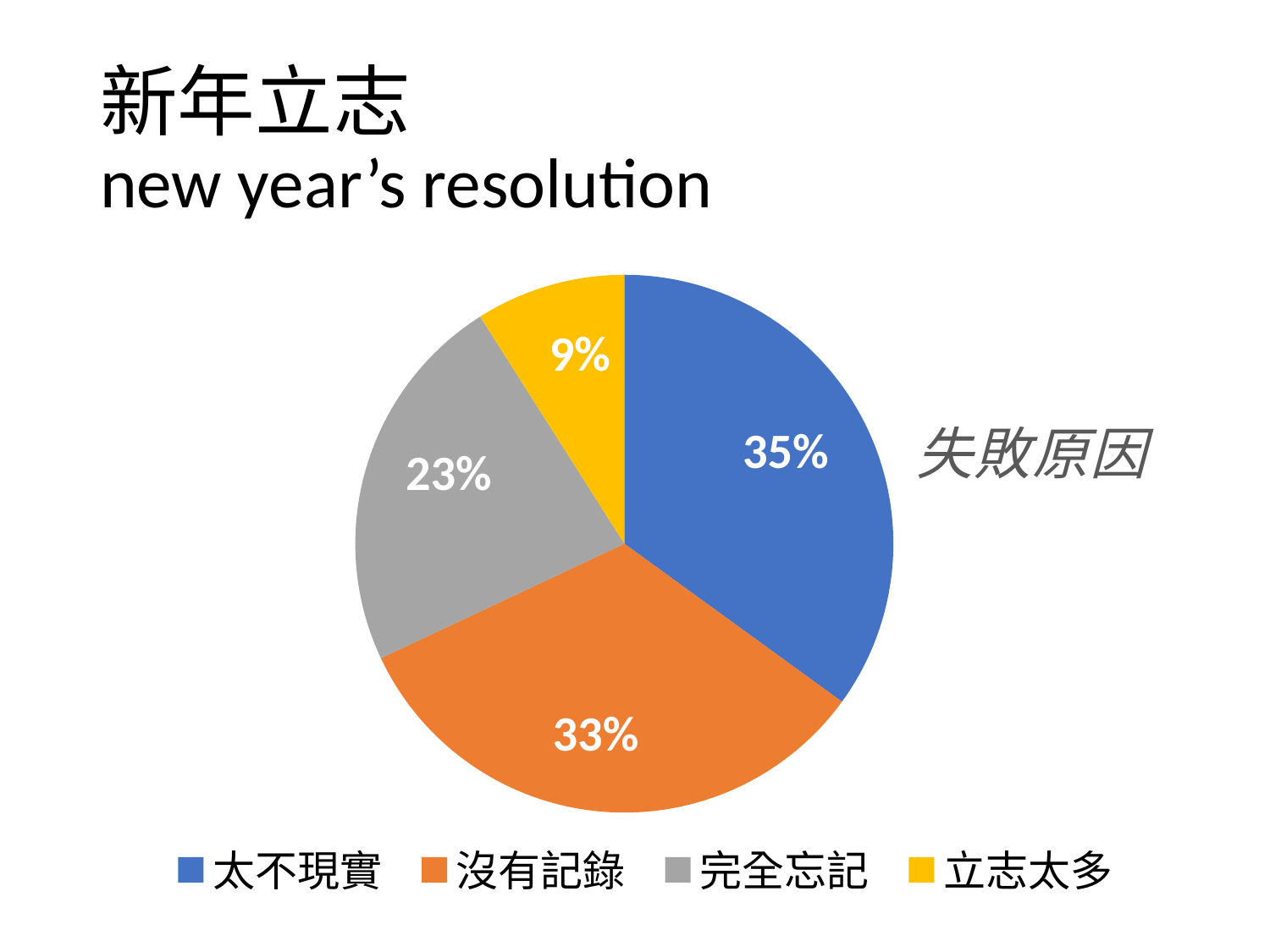
How many categories does the legend list? 4 What share of the pie does 太不現實 represent? 35% Which is larger, the slice for 完全忘記 or the slice for 立志太多? 完全忘記 What is the difference in percentage points between 沒有記錄 and 完全忘記? 10 What is the difference in percentage points between 太不現實 and 立志太多? 26 What share of the pie does 沒有記錄 represent? 33% Which category has the smallest slice of the pie? 立志太多 What share of the pie does 完全忘記 represent? 23% Which category has the largest slice of the pie? 太不現實 What kind of chart is shown on the slide? pie chart What colour is the slice for 沒有記錄? orange